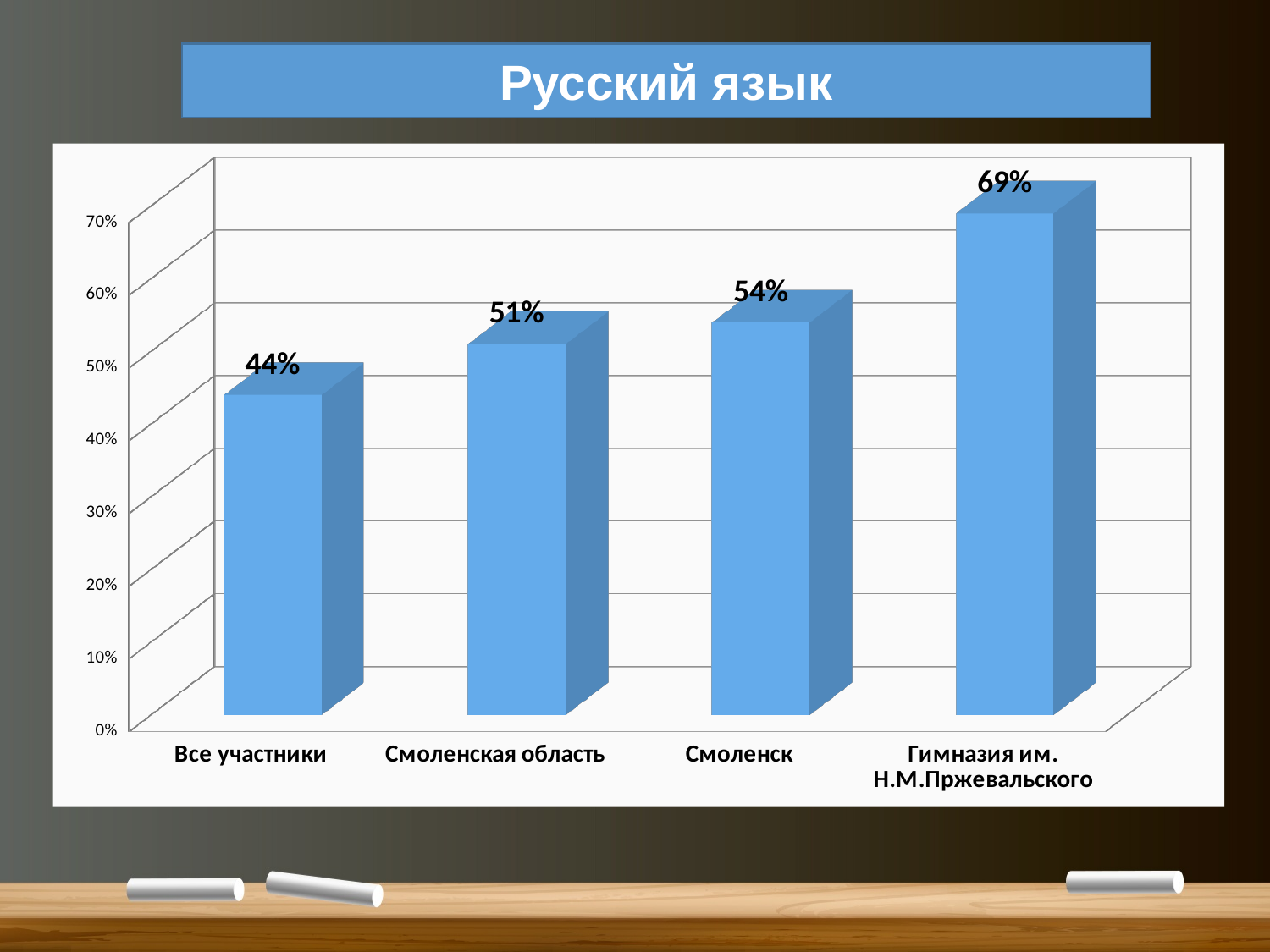
What is the difference between the values for Гимназия им. Н.М.Пржевальского and Все участники? 25% How many categories are shown on the chart? 4 What is the value for Смоленская область? 51% What is the value for Все участники? 44% Which is larger, the value for Смоленск or the value for Все участники? Смоленск Do the values rise or fall from left to right along the x axis? Rise Which category has the highest value? Гимназия им. Н.М.Пржевальского What is the value for Смоленск? 54% What is the value for Гимназия им. Н.М.Пржевальского? 69% Which category has the lowest value? Все участники What is the difference between the values for Смоленск and Смоленская область? 3% What kind of chart is shown on the slide? Bar chart